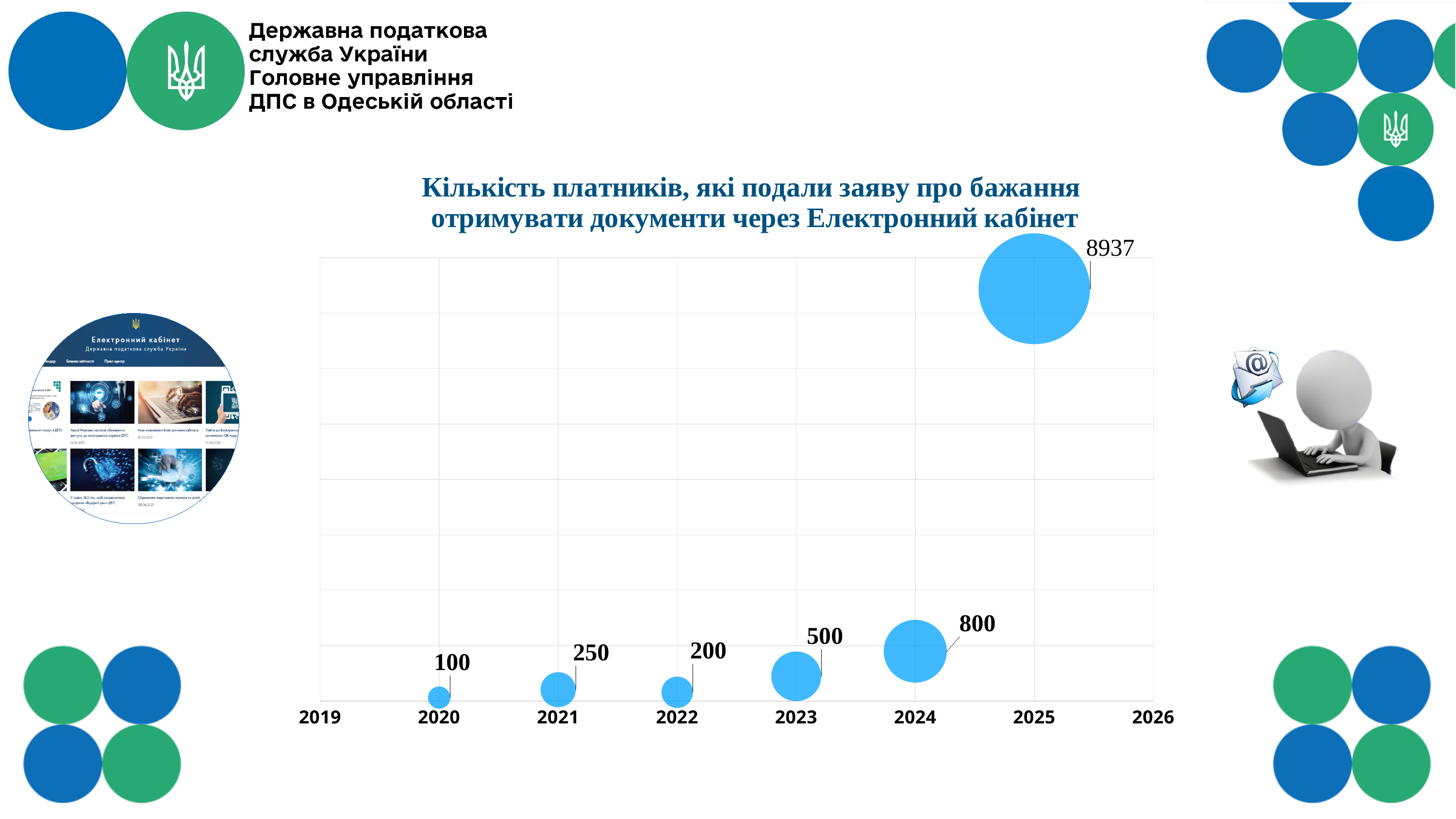
Which year has the lowest value? 2020 What is the value shown for 2020? 100 What is the value shown for 2025? 8937 How many data points (bubbles) are plotted on the chart? 6 What is the difference between the values for 2023 and 2022? 300 What is the value shown for 2021? 250 What is the value shown for 2023? 500 What is the difference between the values for 2025 and 2024? 8137 Which year has the highest value? 2025 Which is larger, the value for 2021 or the value for 2022? 2021 What kind of chart is shown on the slide? Bubble chart What is the title of the chart? Кількість платників, які подали заяву про бажання отримувати документи через Електронний кабінет